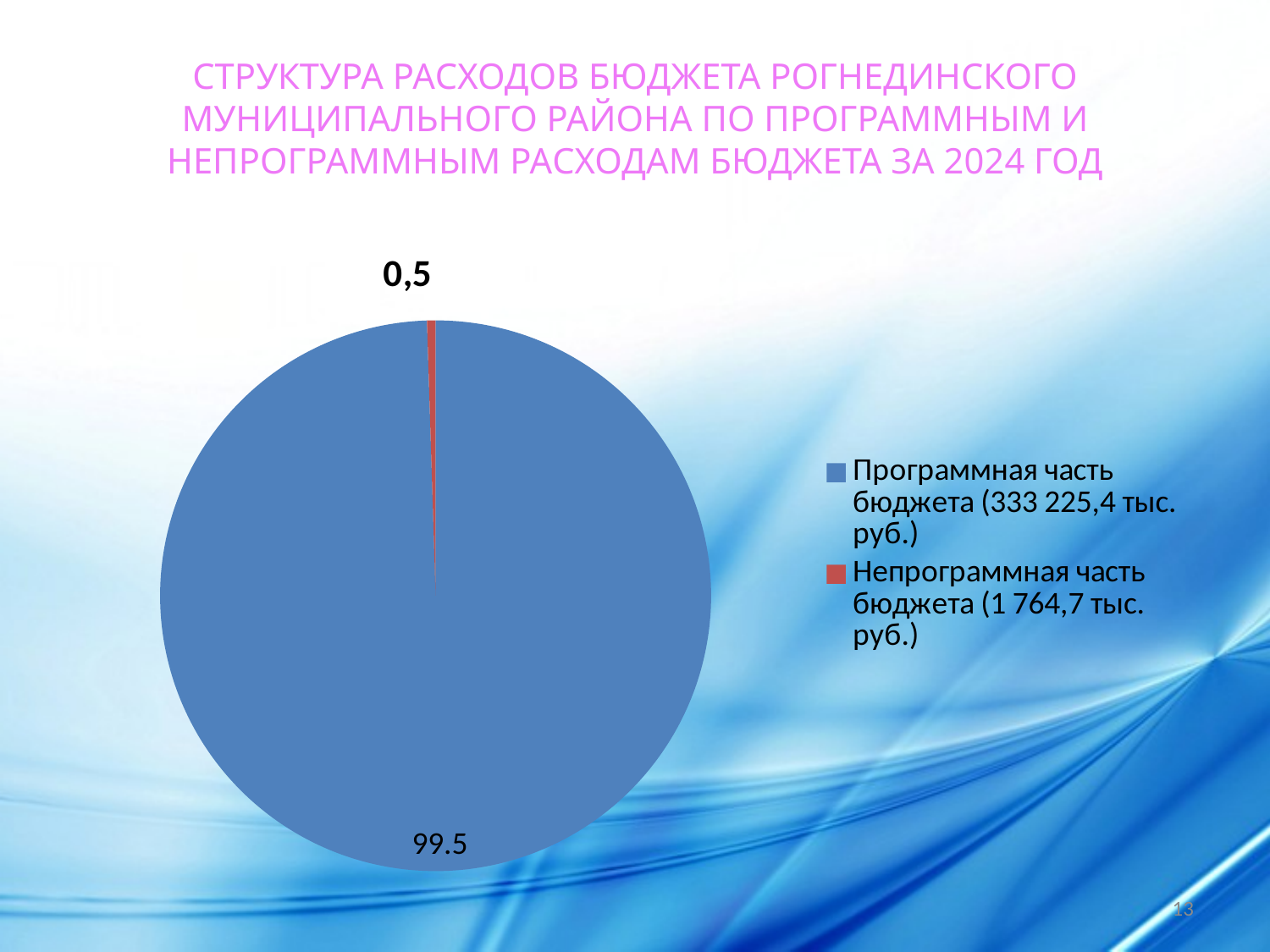
What is the difference between the labelled values of the two slices (99.5 and 0,5)? 99 Which is larger, the slice for Программная часть бюджета or the slice for Непрограммная часть бюджета? Программная часть бюджета What value is labelled on the slice for Программная часть бюджета? 99.5 How many entries does the legend list? 2 What amount in тыс. руб. does the legend give for Непрограммная часть бюджета? 1 764,7 тыс. руб. How many slices does the pie chart have? 2 What kind of chart is shown on the slide? pie chart Which slice of the pie is the smallest? Непрограммная часть бюджета What value is labelled on the slice for Непрограммная часть бюджета? 0,5 What amount in тыс. руб. does the legend give for Программная часть бюджета? 333 225,4 тыс. руб. What is the total of the two labelled slice values? 100 Which slice of the pie is the largest? Программная часть бюджета